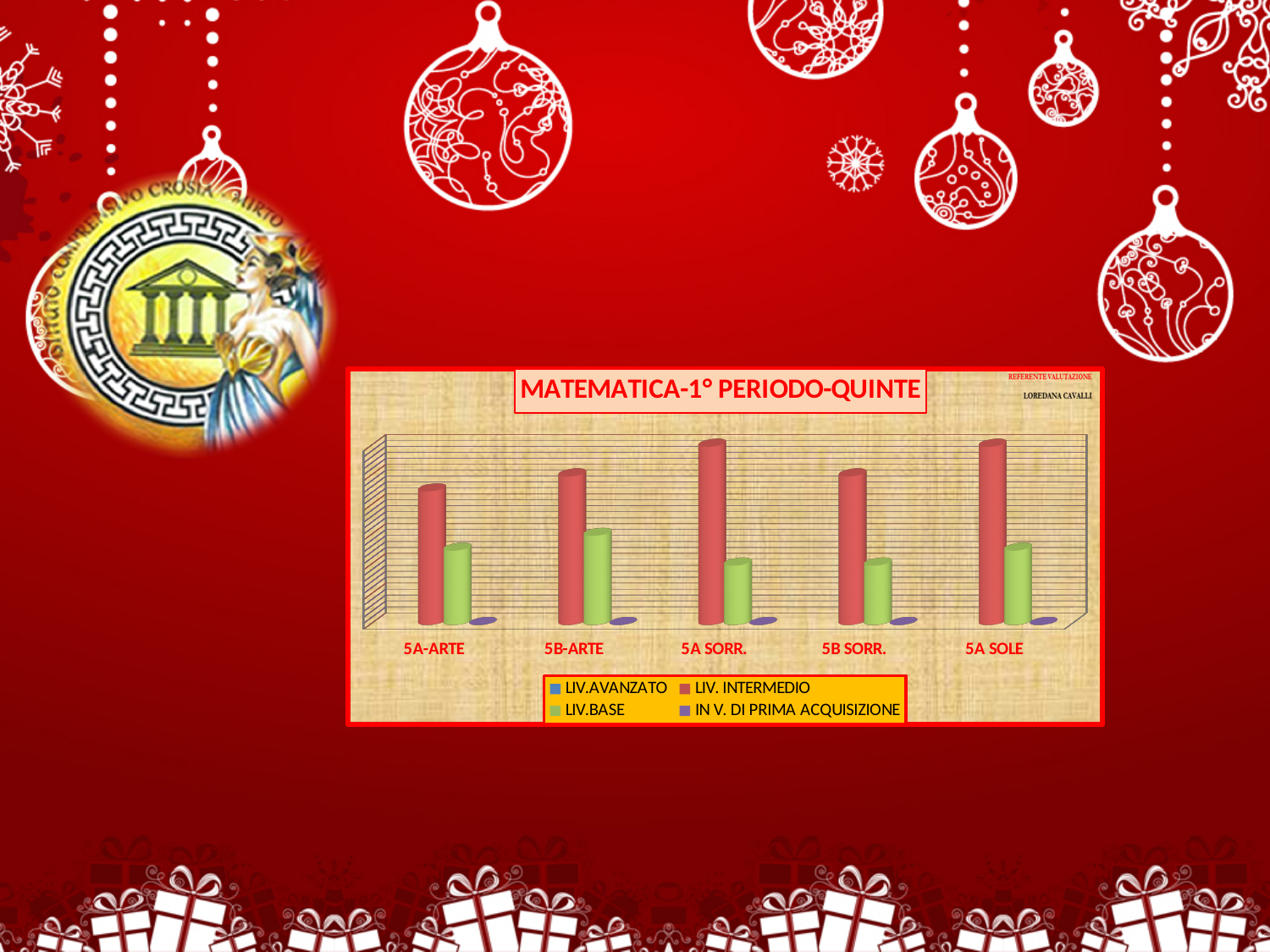
For 5B-ARTE, which is larger: the LIV.BASE bar or the LIV. INTERMEDIO bar? LIV. INTERMEDIO What kind of chart is shown on the slide? Bar chart Is the LIV.BASE bar larger for 5B-ARTE or for 5A SORR.? 5B-ARTE What is the title of the chart? MATEMATICA-1° PERIODO-QUINTE How many series does the chart legend list? 4 Is the LIV. INTERMEDIO bar larger for 5B SORR. or for 5A-ARTE? 5B SORR. Which series is shown in green in the chart? LIV.BASE Which class has the highest LIV.BASE bar? 5B-ARTE Which class has the lowest LIV. INTERMEDIO bar? 5A-ARTE How many classes (categories) are shown on the x axis of the chart? 5